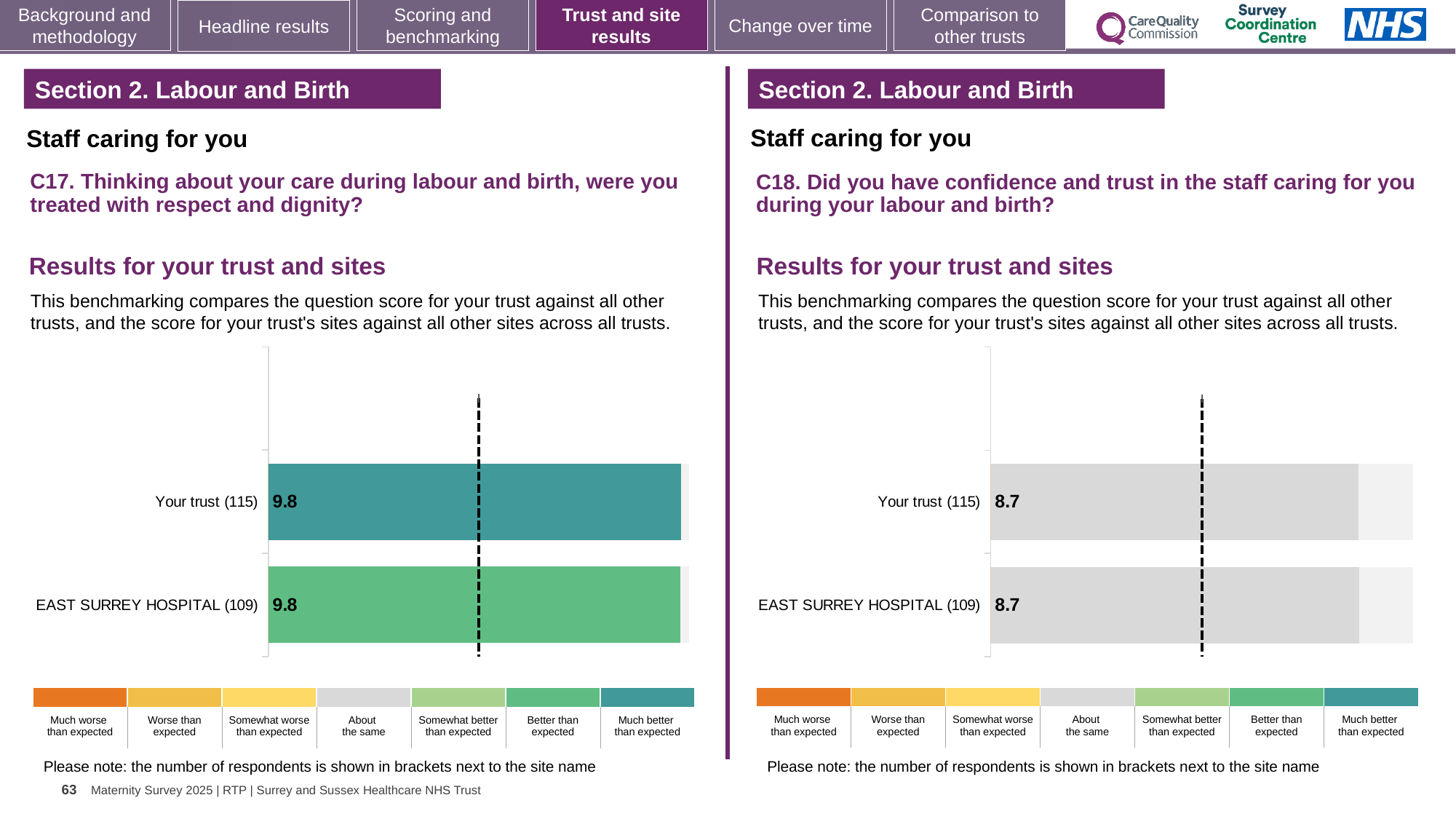
What type of chart is used on the right (C18)? Bar chart On the left chart (C17), which benchmark category does the colour of the Your trust bar correspond to in the legend? Much better than expected How many bars are plotted on the left chart (C17)? 2 On the left chart (C17), what is the difference between the score for Your trust and the score for EAST SURREY HOSPITAL? 0 On the left chart (C17), what is the score for EAST SURREY HOSPITAL (109)? 9.8 On the left chart (C17), what is the score for Your trust (115)? 9.8 On the right chart (C18), what is the score for EAST SURREY HOSPITAL (109)? 8.7 On the right chart (C18), which benchmark category does the colour of the EAST SURREY HOSPITAL bar correspond to in the legend? About the same On the right chart (C18), what is the difference between the score for Your trust and the score for EAST SURREY HOSPITAL? 0 How many bars are plotted on the right chart (C18)? 2 On the right chart (C18), what is the score for Your trust (115)? 8.7 What type of chart is used on the left (C17)? Bar chart